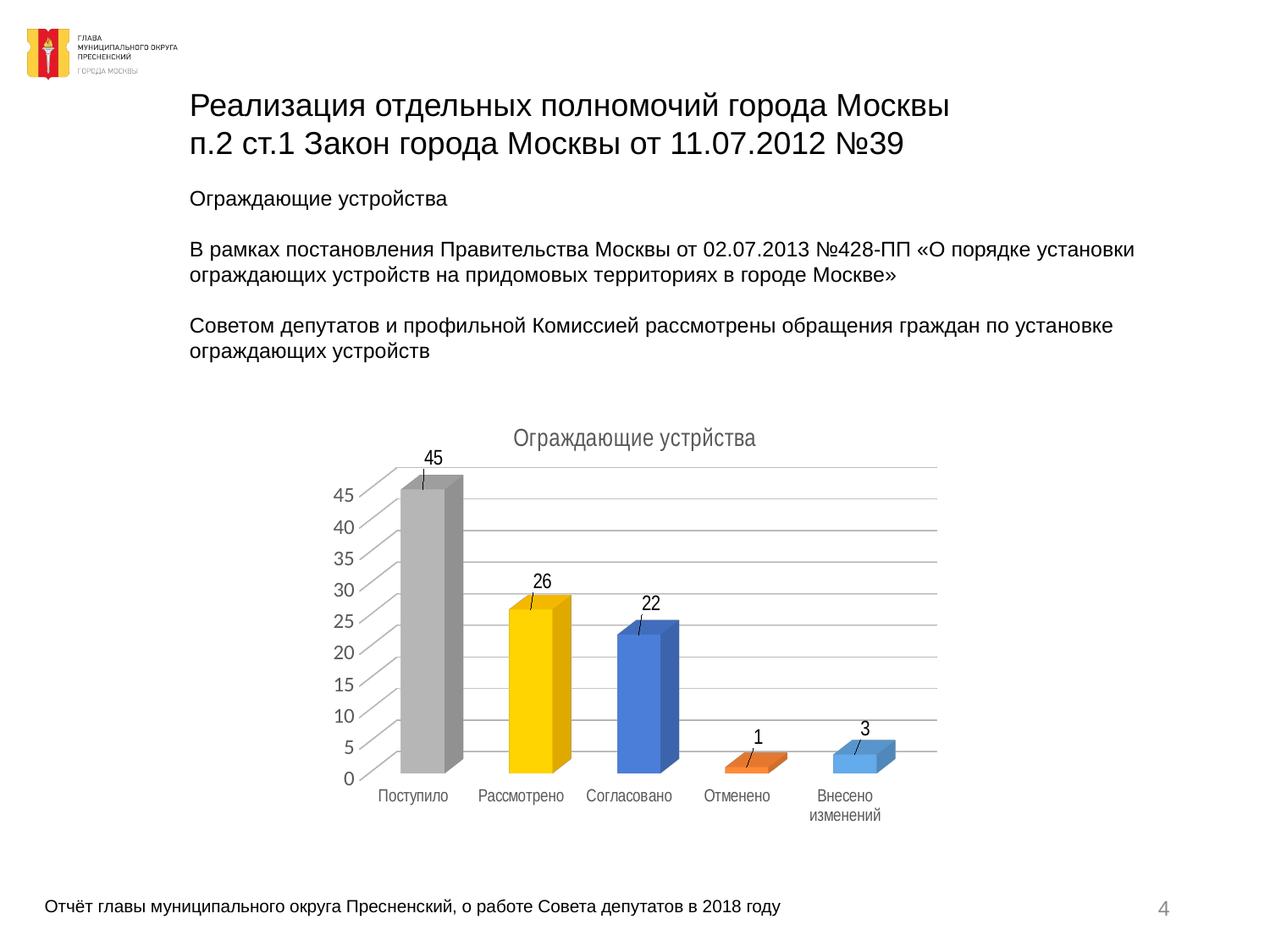
Which category has the lowest value? Отменено Which category has the highest value? Поступило What is the difference between the values for Поступило and Рассмотрено? 19 What is the value for Согласовано? 22 What is the title of the chart? Ограждающие устрйства Which is larger, the value for Отменено or the value for Внесено изменений? Внесено изменений What is the value for Рассмотрено? 26 What kind of chart is shown on the slide? Bar chart What is the value for Внесено изменений? 3 How many categories are shown on the x axis? 5 What is the value for Поступило? 45 What is the difference between the values for Рассмотрено and Согласовано? 4